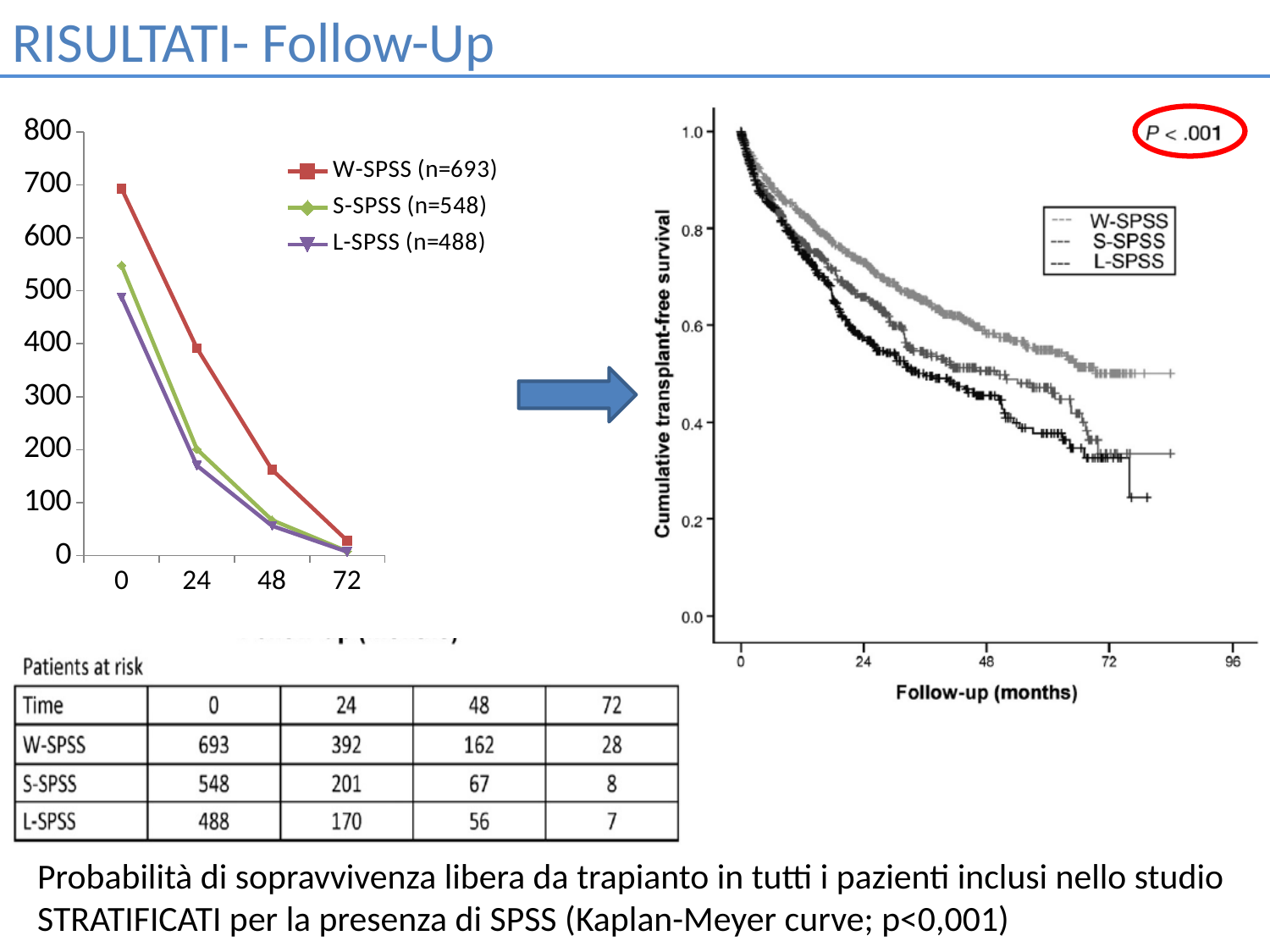
On the left line chart, which is larger at time 48: W-SPSS or L-SPSS? W-SPSS On the left line chart, what is the value for W-SPSS at time 24? 392 On the right Kaplan-Meier chart, what is the label of the x axis? Follow-up (months) On the left line chart, what is the value for S-SPSS at time 48? 67 On the left line chart, how many time points are shown on the x axis? 4 On the left line chart, what type of chart is it? line chart On the left line chart, how many series does the legend list? 3 On the left line chart, what is the difference between W-SPSS and S-SPSS at time 0? 145 On the left line chart, which series has the lowest value at time 24? L-SPSS On the left line chart, which series has the highest value at time 0? W-SPSS On the left line chart, what is the value for L-SPSS at time 72? 7 On the left line chart, do the values rise or fall as time increases from 0 to 72? fall